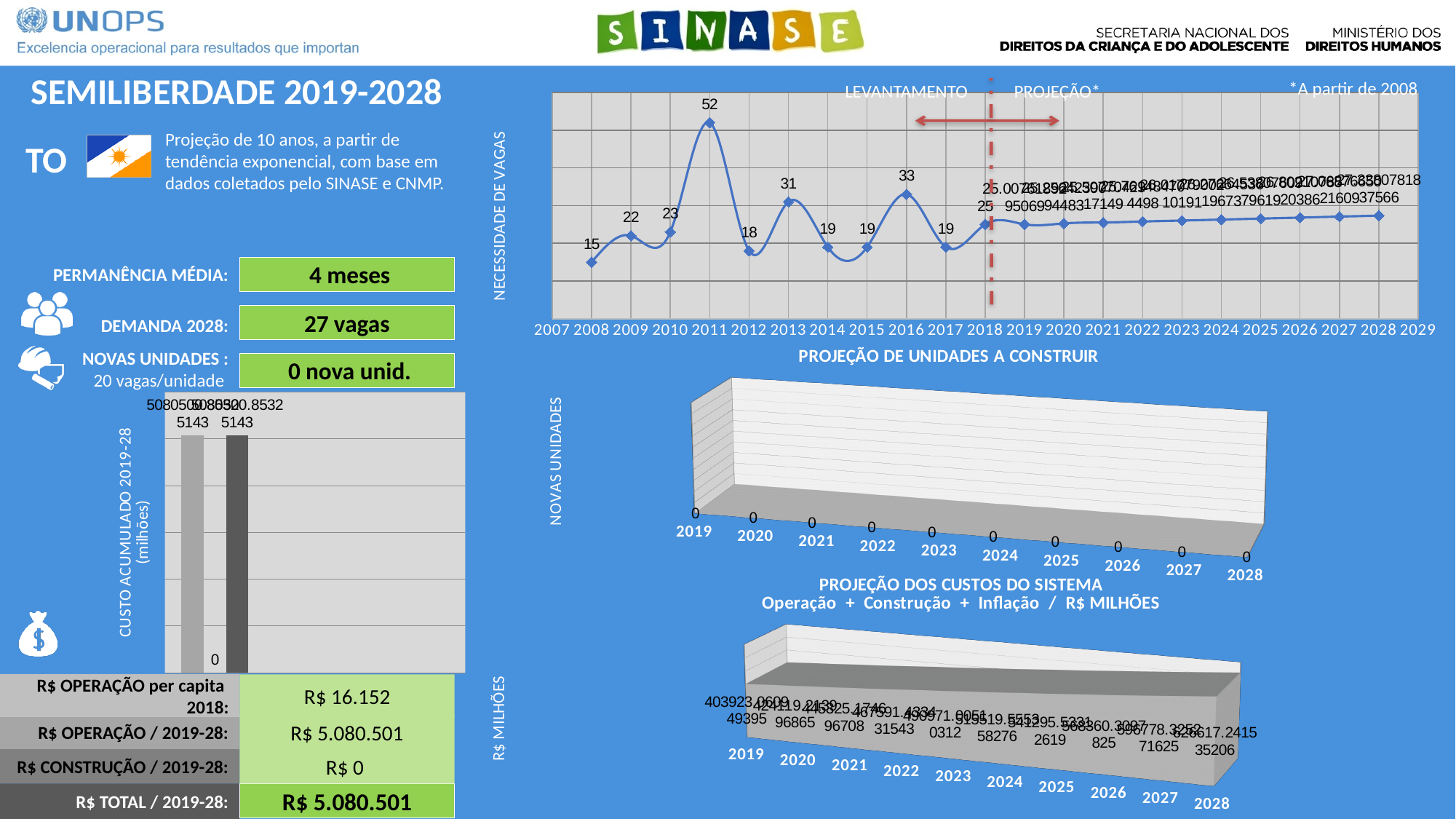
In the line chart of NECESSIDADE DE VAGAS, which is larger, the value for 2013 or the value for 2016? 2016 In the line chart of NECESSIDADE DE VAGAS, which year between 2008 and 2018 has the lowest value? 2008 In the chart titled PROJEÇÃO DE UNIDADES A CONSTRUIR, how many years are shown on the x axis? 10 In the line chart of NECESSIDADE DE VAGAS, do the values rise or fall from 2016 to 2017? fall In the line chart of NECESSIDADE DE VAGAS, which year between 2008 and 2018 has the highest value? 2011 In the line chart of NECESSIDADE DE VAGAS, what is the value for 2016? 33 What kind of chart is the chart titled PROJEÇÃO DE UNIDADES A CONSTRUIR? 3D area chart In the line chart of NECESSIDADE DE VAGAS, what is the value for 2008? 15 In the chart titled PROJEÇÃO DE UNIDADES A CONSTRUIR, what is the value for 2024? 0 In the line chart of NECESSIDADE DE VAGAS, what is the value for 2011? 52 In the line chart of NECESSIDADE DE VAGAS, what is the value for 2018? 25 In the line chart of NECESSIDADE DE VAGAS, what is the difference between the values for 2011 and 2012? 34